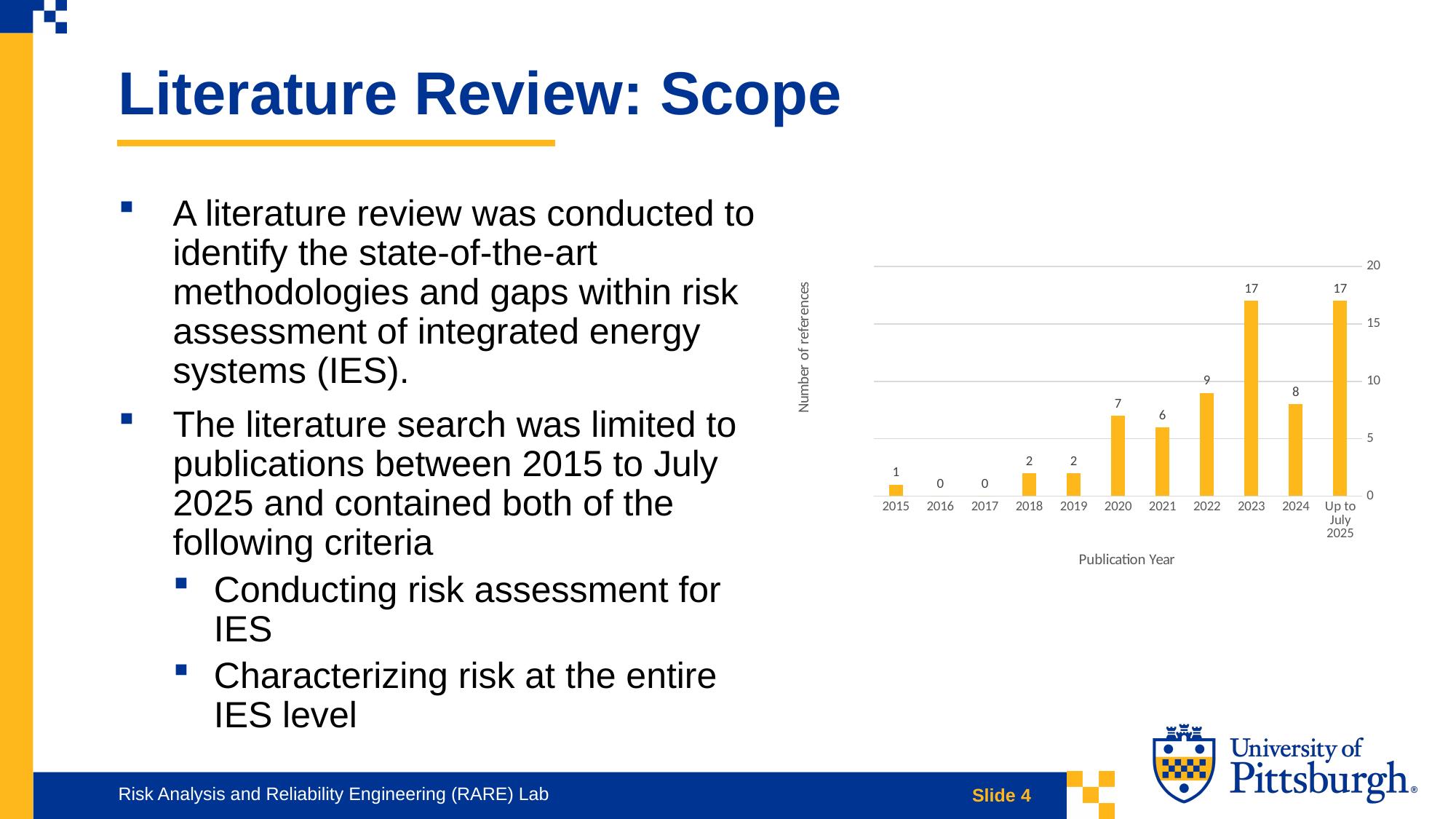
Which publication years have the highest number of references? 2023 and Up to July 2025 What is the label of the x axis of the chart? Publication Year Which publication years have zero references? 2016 and 2017 Which has more references, 2021 or 2022? 2022 Is the value for 2023 greater or less than 15? greater What is the number of references for 2024? 8 What is the number of references for 2018? 2 What is the number of references for 2020? 7 What is the label of the y axis of the chart? Number of references What kind of chart is shown on the slide? Bar chart What is the difference in number of references between 2023 and 2022? 8 How many publication year categories are shown on the x axis? 11